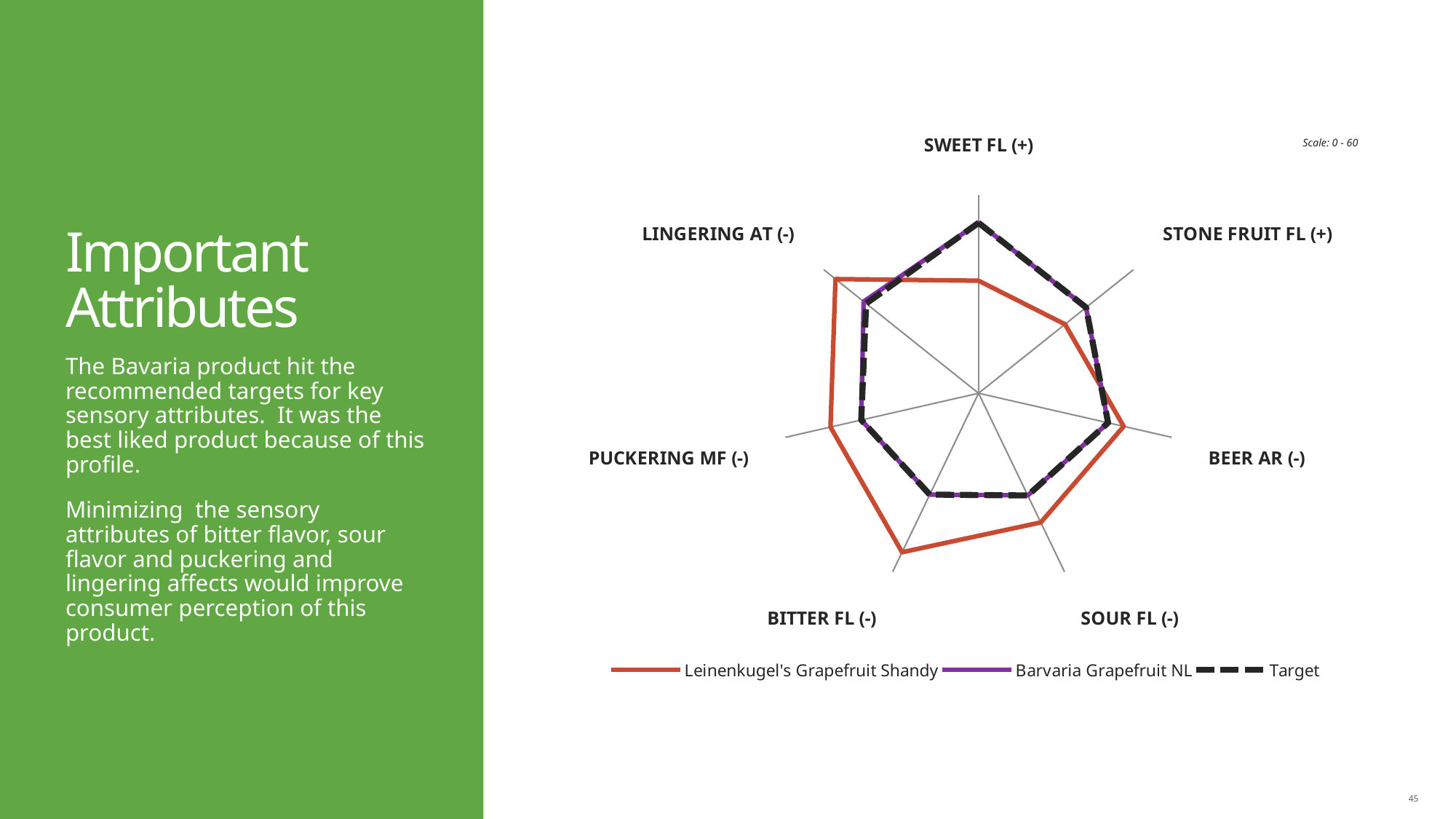
What scale does the note on the radar chart say the attributes are measured on? 0 - 60 How many series does the legend of the radar chart list? 3 On the LINGERING AT (-) axis, which is higher: Leinenkugel's Grapefruit Shandy or Barvaria Grapefruit NL? Leinenkugel's Grapefruit Shandy Which series is drawn with a black dashed line in the radar chart? Target On the BITTER FL (-) axis, which is higher: Leinenkugel's Grapefruit Shandy or Target? Leinenkugel's Grapefruit Shandy On the PUCKERING MF (-) axis, which is higher: Leinenkugel's Grapefruit Shandy or Target? Leinenkugel's Grapefruit Shandy What kind of chart is shown on the slide? Radar chart How many sensory attributes (axes) does the radar chart plot? 7